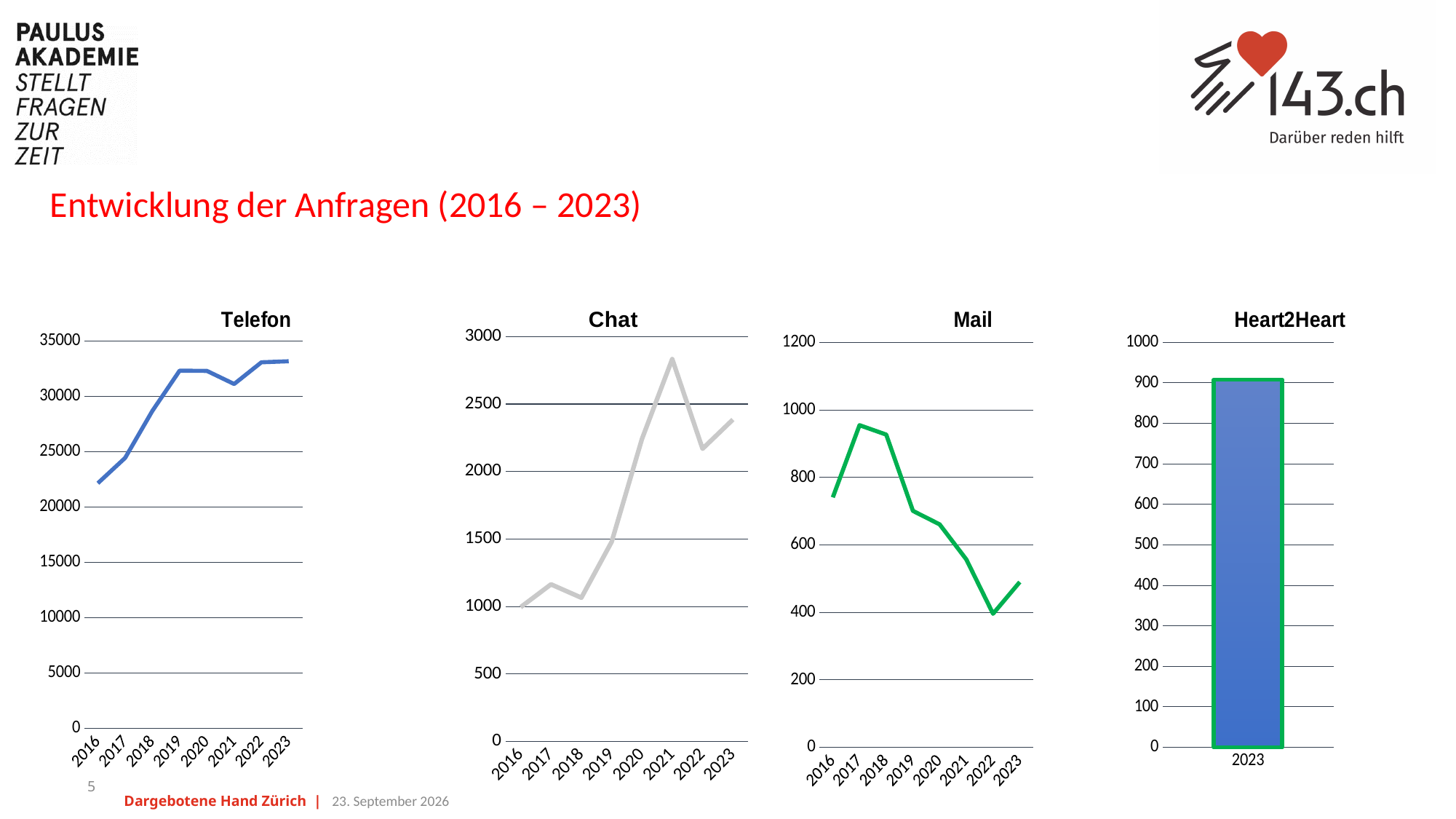
In the Telefon chart, is the value for 2019 greater or less than 30000? greater How many years are shown on the x axis of the Heart2Heart chart? 1 What kind of chart is the Heart2Heart chart? bar chart In the Mail chart, do the values overall rise or fall from 2017 to 2022? fall In the Telefon chart, do the values overall rise or fall from 2016 to 2023? rise In the Telefon chart, which year has the lowest value? 2016 In the Chat chart, is the value for 2021 greater or less than 2500? greater What kind of chart is the Telefon chart? line chart In the Chat chart, which year has the highest value? 2021 In the Mail chart, is the value for 2022 greater or less than 600? less In the Mail chart, which year has the lowest value? 2022 In the Chat chart, which is larger, the value for 2020 or the value for 2018? 2020